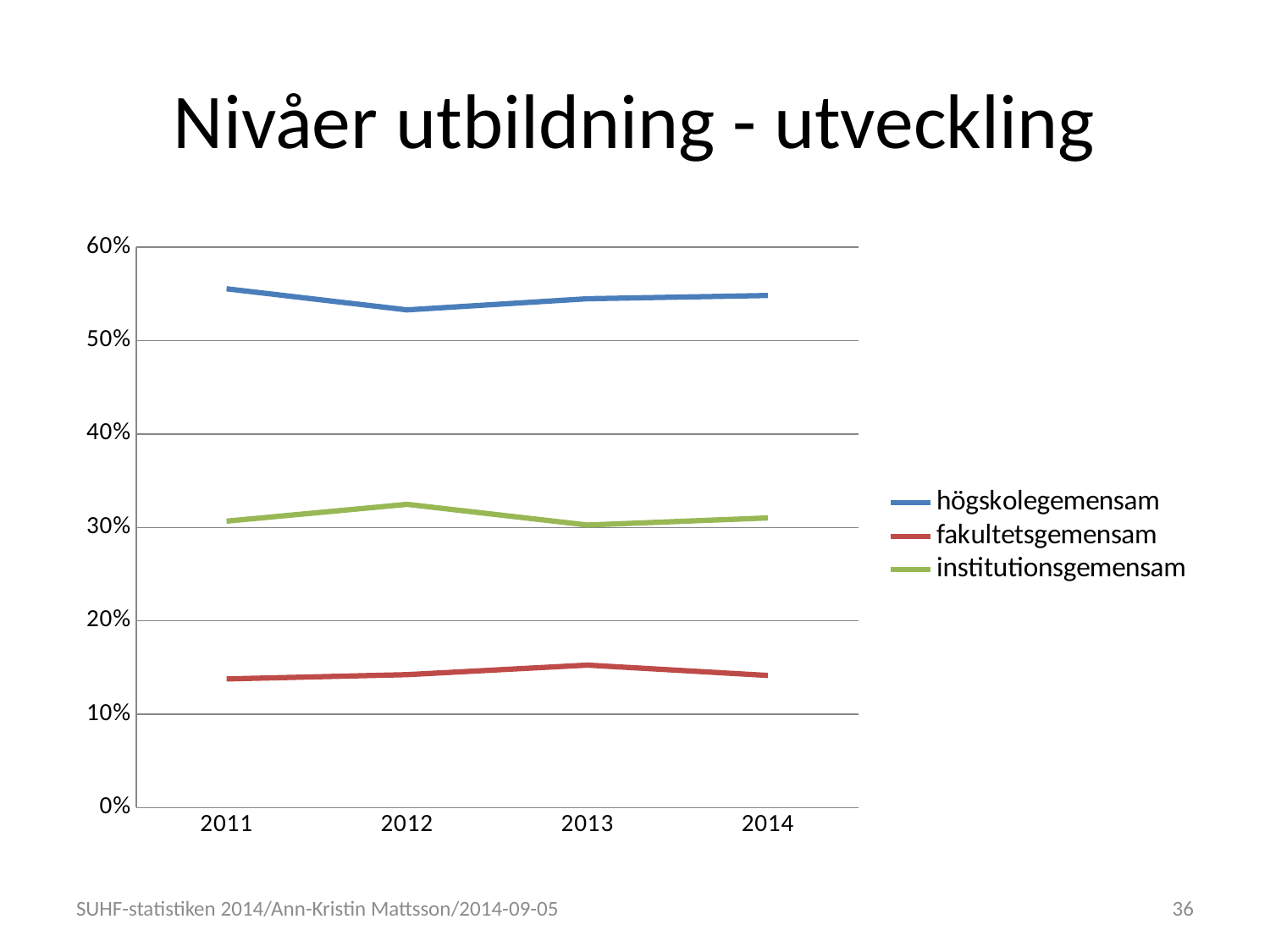
Which series has the highest values across all years? högskolegemensam How many series does the legend list? 3 How many years are shown on the x axis? 4 In 2014, which is larger: institutionsgemensam or fakultetsgemensam? institutionsgemensam Is the value for institutionsgemensam in 2012 greater or less than 30%? greater What is the title of the slide? Nivåer utbildning - utveckling Which series has the lowest values across all years? fakultetsgemensam Does the högskolegemensam line rise or fall from 2011 to 2012? fall Is the value for fakultetsgemensam in 2013 greater or less than 20%? less Is the value for högskolegemensam in 2011 greater or less than 50%? greater What kind of chart is shown on the slide? line chart